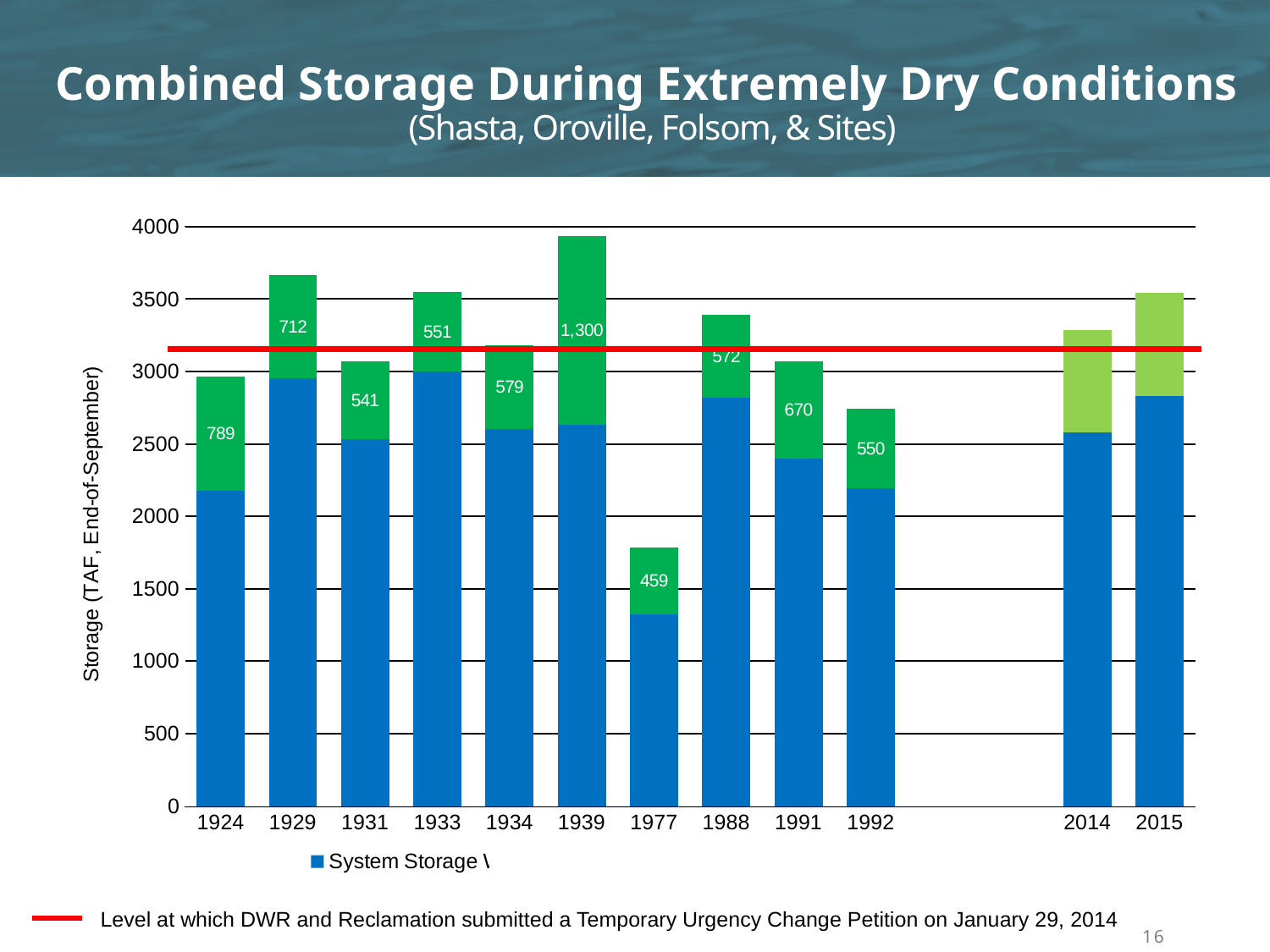
How many years are shown on the x axis? 12 What value is printed on the green segment of the 1924 bar? 789 Is the total height of the 1977 bar greater or less than 2000? less What value is printed on the green segment of the 1977 bar? 459 Which is larger, the green-segment value for 1931 or for 1934? 1934 Which year has the largest printed green-segment value? 1939 What value is printed on the green segment of the 1939 bar? 1,300 What is the difference between the green-segment values printed for 1991 and 1992? 120 What is the difference between the green-segment values printed for 1924 and 1929? 77 Is the total height of the 1939 bar greater or less than 3500? greater What type of chart is shown on the slide? Stacked bar chart Which year has the smallest printed green-segment value? 1977